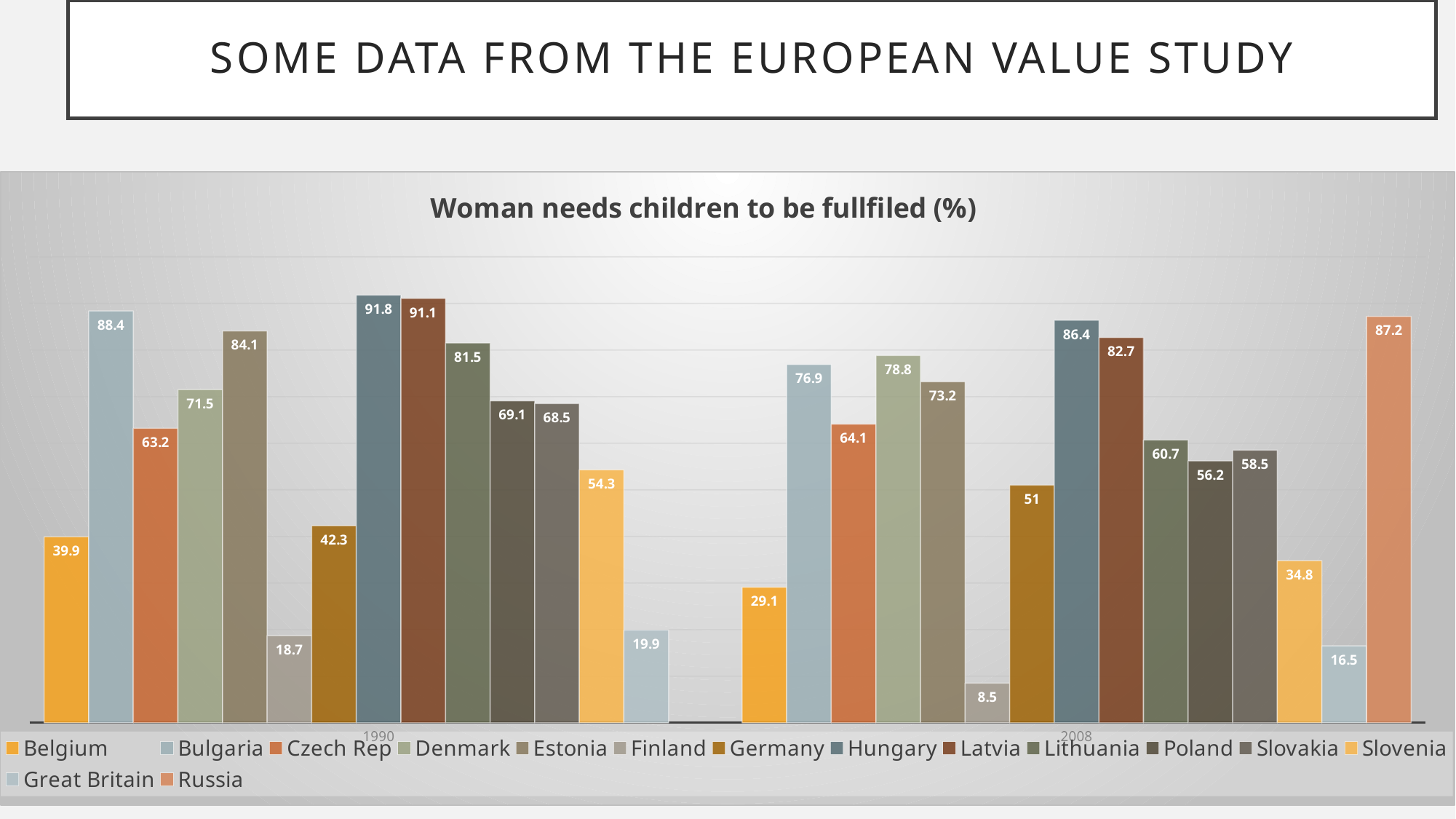
Which country has the highest value in 2008? Russia What is the value for Finland in 2008? 8.5 What kind of chart is shown on the slide? Bar chart In 2008, which is larger: the value for Denmark or the value for Estonia? Denmark Does the value for Bulgaria rise or fall from 1990 to 2008? Fall What is the difference between Belgium's value in 1990 and in 2008? 10.8 What is the value for Hungary in 1990? 91.8 What is the title of the chart? Woman needs children to be fullfiled (%) Which country has the lowest value in 1990? Finland How many series does the legend list? 15 How many year categories are shown on the x axis? 2 What is the value for Germany in 2008? 51